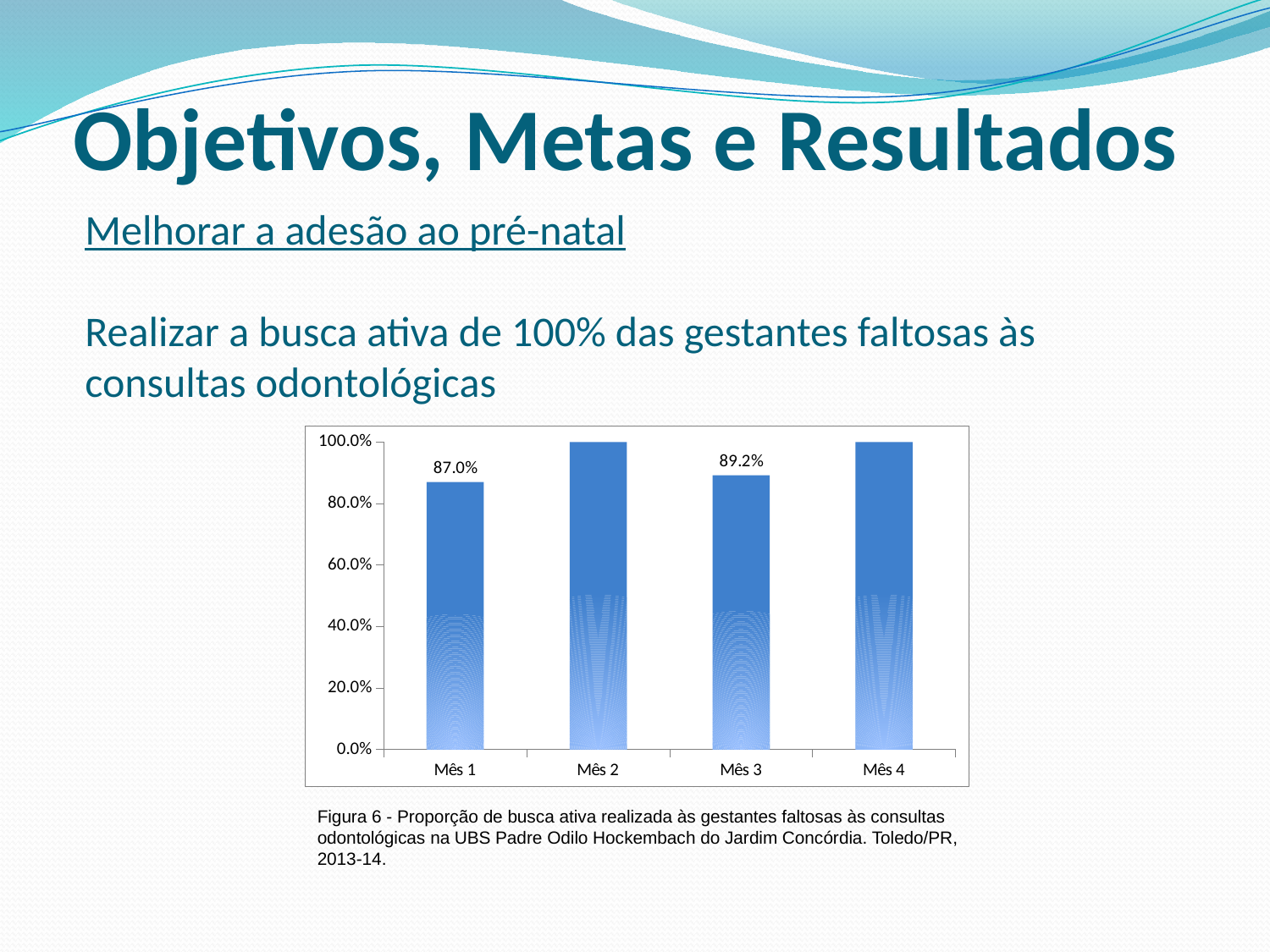
What is the value for Mês 3? 89.2% How many months are shown on the x axis? 4 Which is larger, the value for Mês 1 or the value for Mês 3? Mês 3 What is the value for Mês 2? 100.0% What is the value for Mês 4? 100.0% Does the value rise or fall from Mês 1 to Mês 2? rise What kind of chart is shown on the slide? bar chart Is the value for Mês 1 greater or less than 80.0%? greater What is the difference between the values for Mês 3 and Mês 1? 2.2 percentage points What is the value for Mês 1? 87.0% What is the difference between the values for Mês 2 and Mês 1? 13.0 percentage points Which month has the lowest value? Mês 1